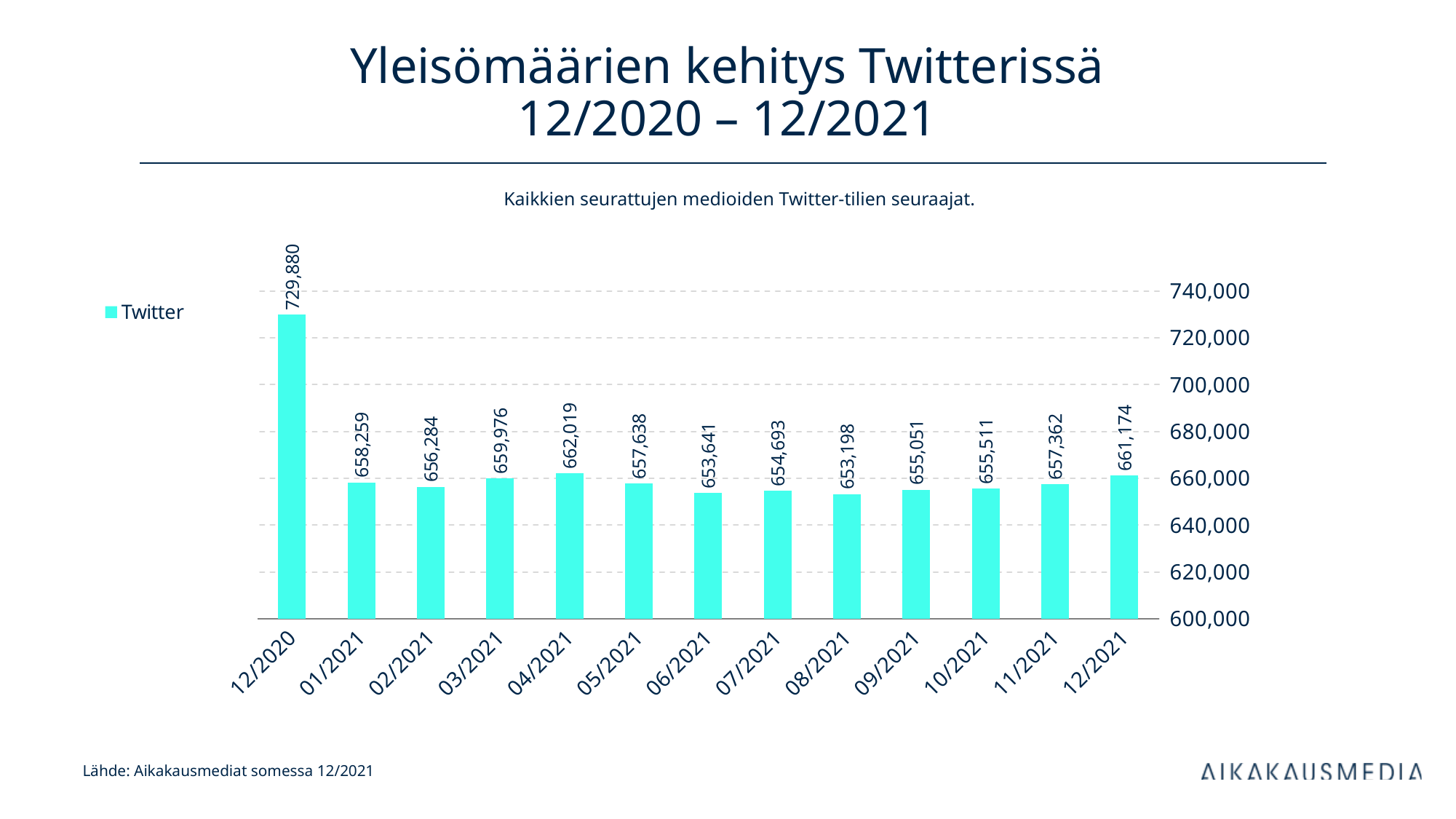
Which month has the lowest value? 08/2021 How many series does the legend list? 1 What is the difference between the values for 12/2020 and 12/2021? 68,706 Is the value for 12/2020 greater or less than 720,000? greater Which is larger, the value for 03/2021 or the value for 04/2021? 04/2021 What is the value for 12/2020? 729,880 What type of chart is shown on the slide? bar chart How many months are shown on the x axis? 13 Which month has the highest value? 12/2020 What is the value for 06/2021? 653,641 What is the difference between the values for 12/2020 and 01/2021? 71,621 What is the value for 12/2021? 661,174